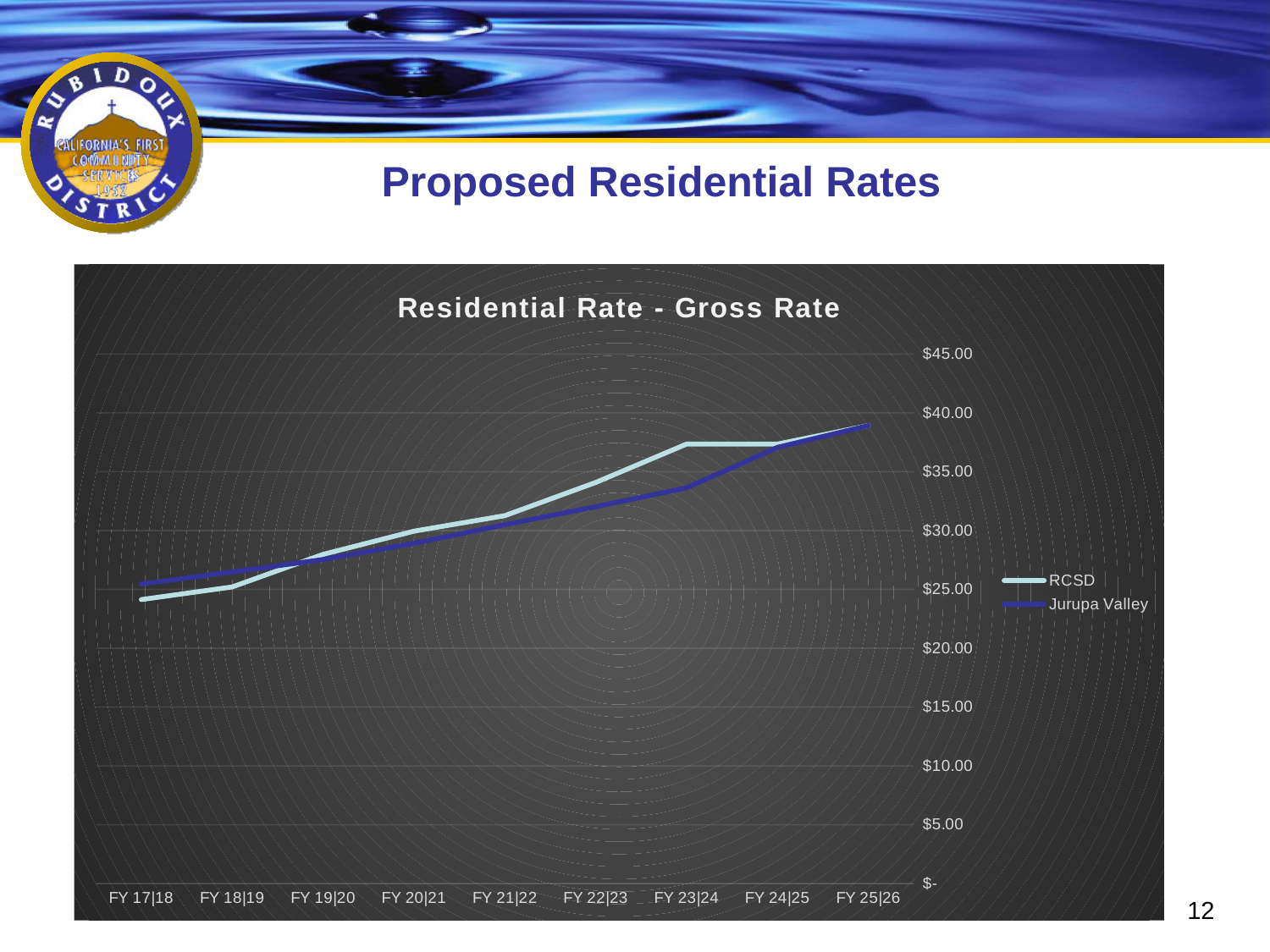
What kind of chart is shown on the slide? line chart Does the RCSD rate rise or fall from FY 17|18 to FY 25|26? rise Which series is drawn in the light blue line? RCSD At FY 17|18, which series has the higher rate, RCSD or Jurupa Valley? Jurupa Valley At FY 23|24, which series has the higher rate, RCSD or Jurupa Valley? RCSD Is the RCSD value for FY 17|18 greater or less than $30.00? less Is the Jurupa Valley value for FY 23|24 greater or less than $35.00? less How many series does the legend list? 2 Does the Jurupa Valley rate rise or fall from FY 17|18 to FY 25|26? rise What is the title of the chart? Residential Rate - Gross Rate Is the RCSD value for FY 23|24 greater or less than $35.00? greater How many fiscal years are shown along the x axis? 9